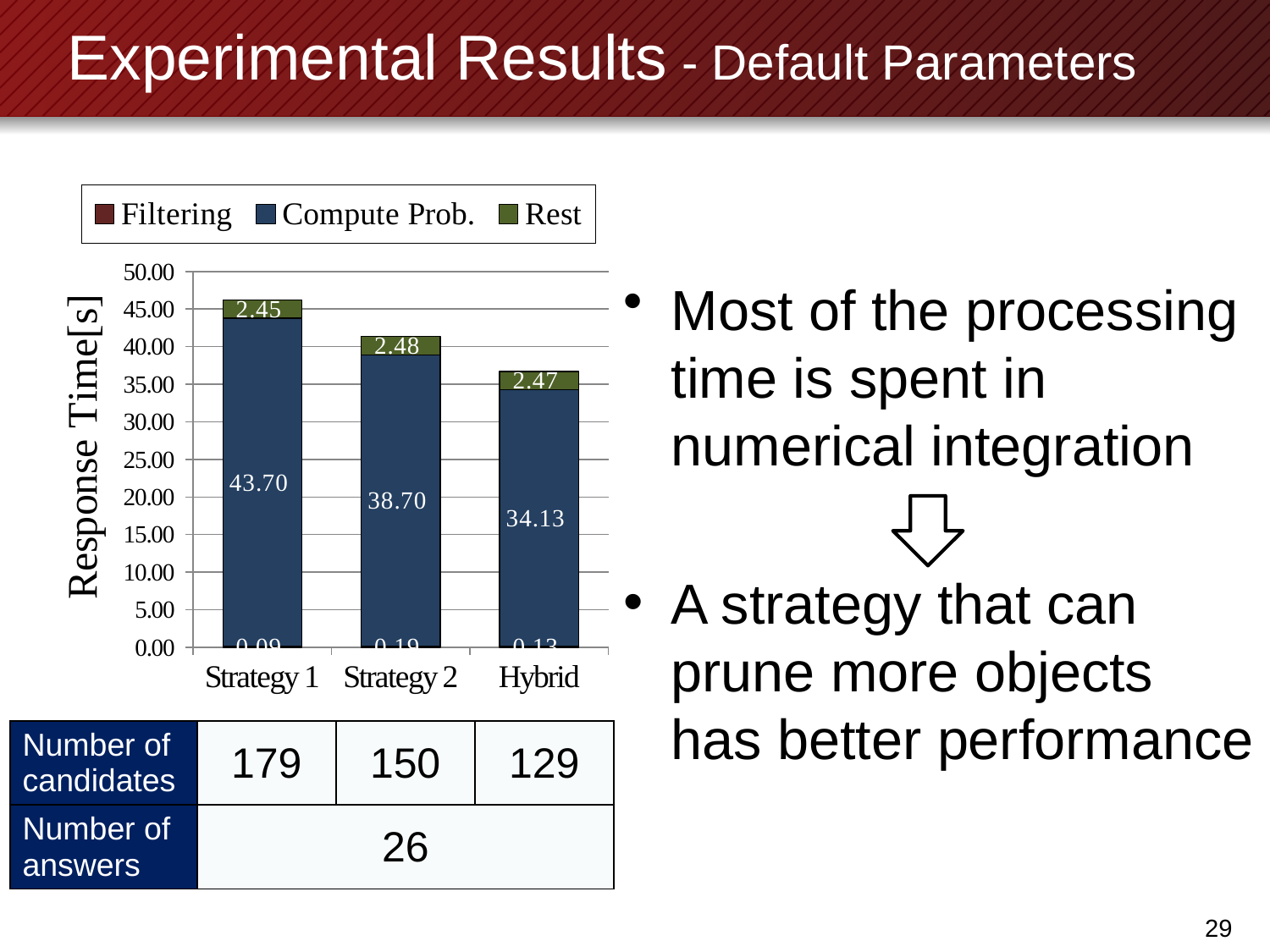
What kind of chart is shown on the slide? Stacked bar chart Is the Compute Prob. value larger for Strategy 2 or Hybrid? Strategy 2 How many series does the legend list? 3 What is the Rest value for Strategy 2? 2.48 What is the Compute Prob. value for Hybrid? 34.13 What is the Rest value for Hybrid? 2.47 Which category has the lowest Compute Prob. value? Hybrid Which category has the highest Compute Prob. value? Strategy 1 What is the Compute Prob. value for Strategy 2? 38.70 What is the difference between the Compute Prob. values for Strategy 1 and Hybrid? 9.57 What is the Compute Prob. value for Strategy 1? 43.70 How many categories are shown on the x axis? 3